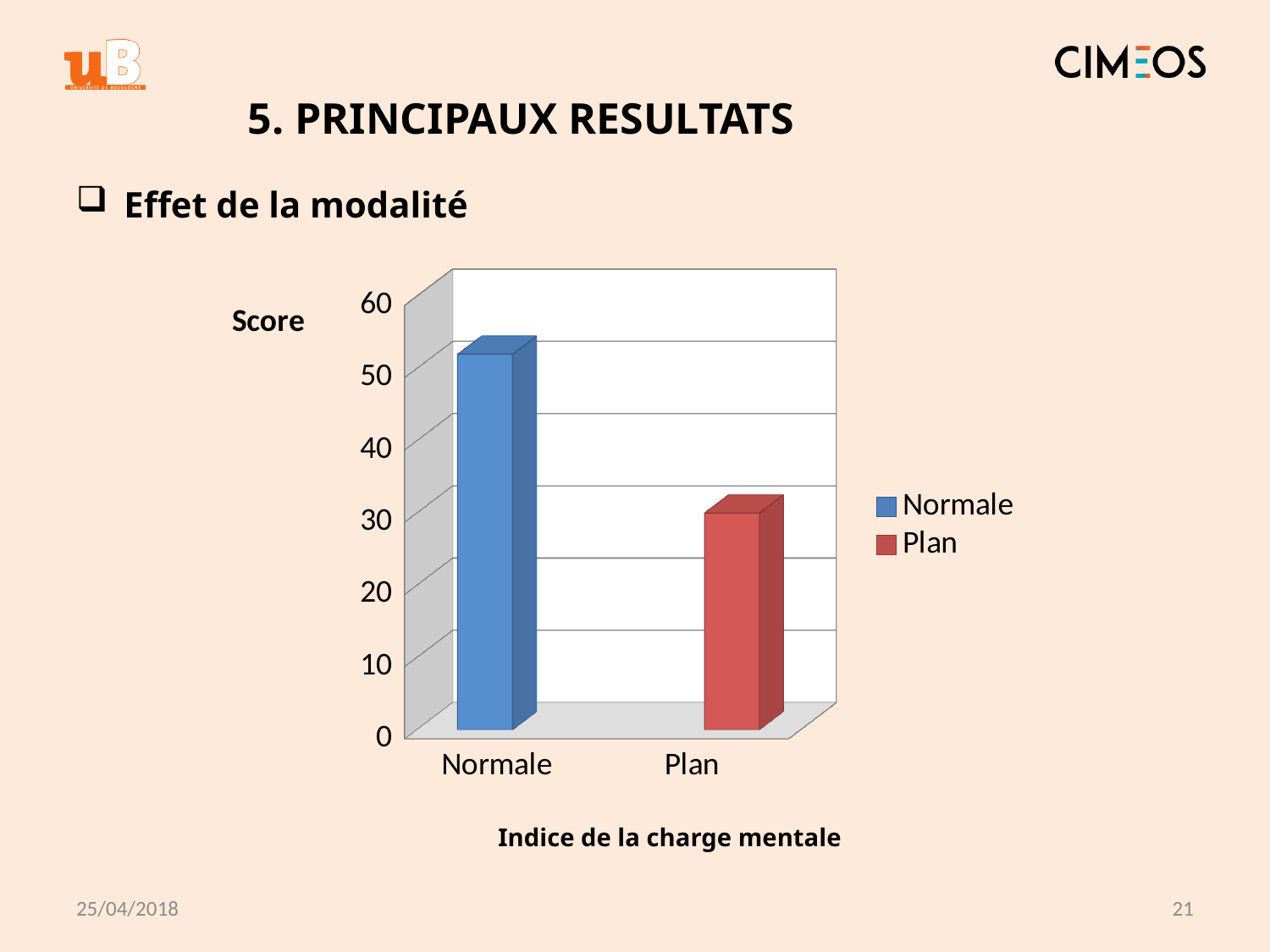
Is the value for Normale greater or less than 40? greater Is the value for Plan greater or less than 20? greater What is the label of the vertical axis? Score How many bars are plotted in the chart? 2 What colour is the bar for Plan? red How many entries does the legend list? 2 Which category has the highest score? Normale What kind of chart is shown on the slide? bar chart Which category has the lowest score? Plan Which is larger, the score for Normale or the score for Plan? Normale Is the value for Plan greater or less than 40? less